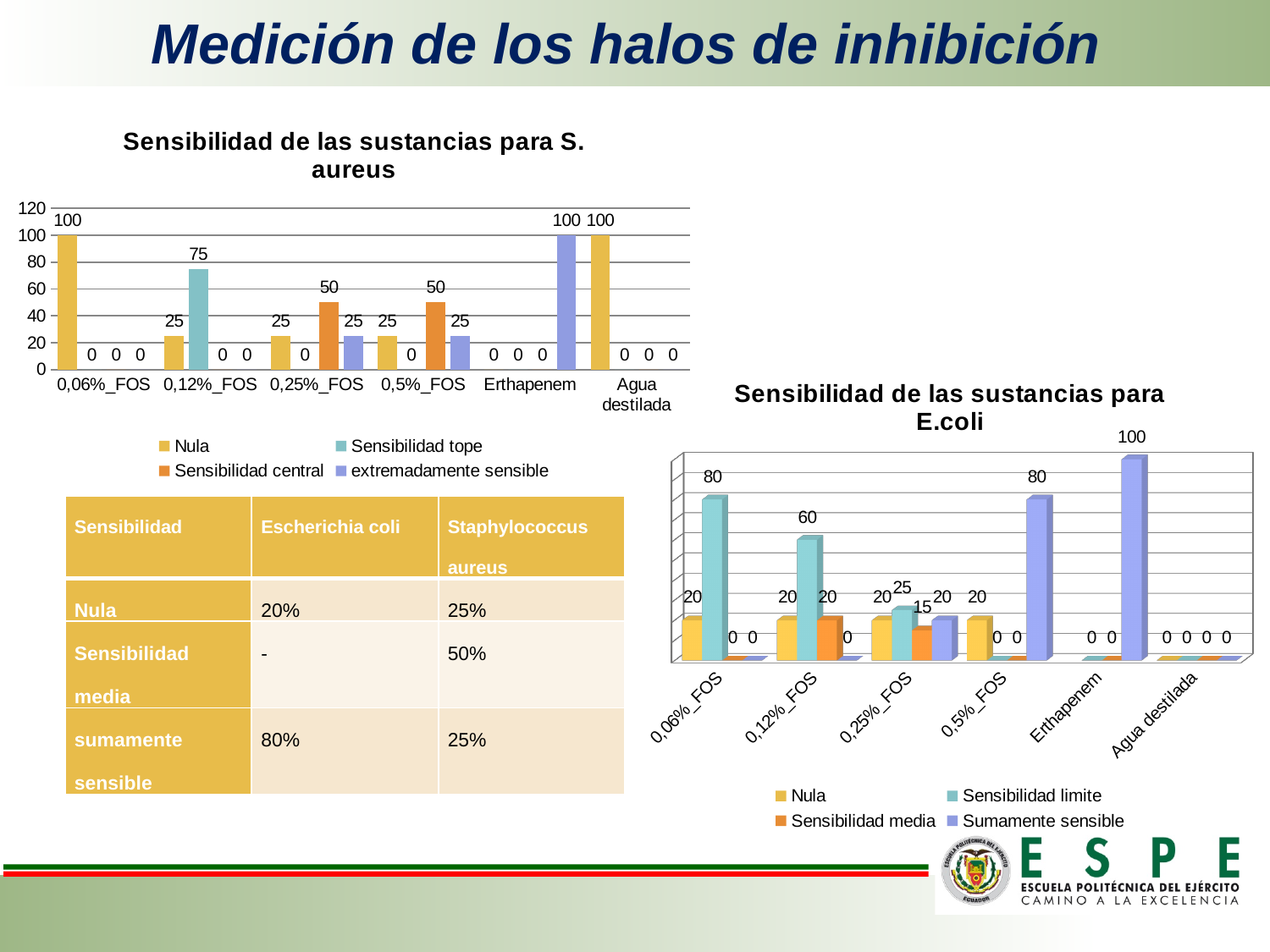
In the 'Sensibilidad de las sustancias para S. aureus' chart, how many categories are shown on the x axis? 6 In the 'Sensibilidad de las sustancias para E.coli' chart, which is larger for 0,12%_FOS: Sensibilidad limite or Sensibilidad media? Sensibilidad limite In the 'Sensibilidad de las sustancias para S. aureus' chart, what is the value of Sensibilidad central for 0,25%_FOS? 50 In the 'Sensibilidad de las sustancias para E.coli' chart, which category has the highest Sumamente sensible value? Erthapenem In the 'Sensibilidad de las sustancias para S. aureus' chart, what is the value of Nula for 0,06%_FOS? 100 In the 'Sensibilidad de las sustancias para E.coli' chart, what is the value of Sensibilidad limite for 0,06%_FOS? 80 In the 'Sensibilidad de las sustancias para S. aureus' chart, what is the difference between Sensibilidad tope and Nula for 0,12%_FOS? 50 In the 'Sensibilidad de las sustancias para S. aureus' chart, how many series does the legend list? 4 In the 'Sensibilidad de las sustancias para E.coli' chart, what is the value of Sumamente sensible for Erthapenem? 100 In the 'Sensibilidad de las sustancias para E.coli' chart, what is the value of Sensibilidad media for 0,25%_FOS? 15 In the 'Sensibilidad de las sustancias para S. aureus' chart, what is the value of Sensibilidad tope for 0,12%_FOS? 75 What type of chart is 'Sensibilidad de las sustancias para E.coli'? Bar chart